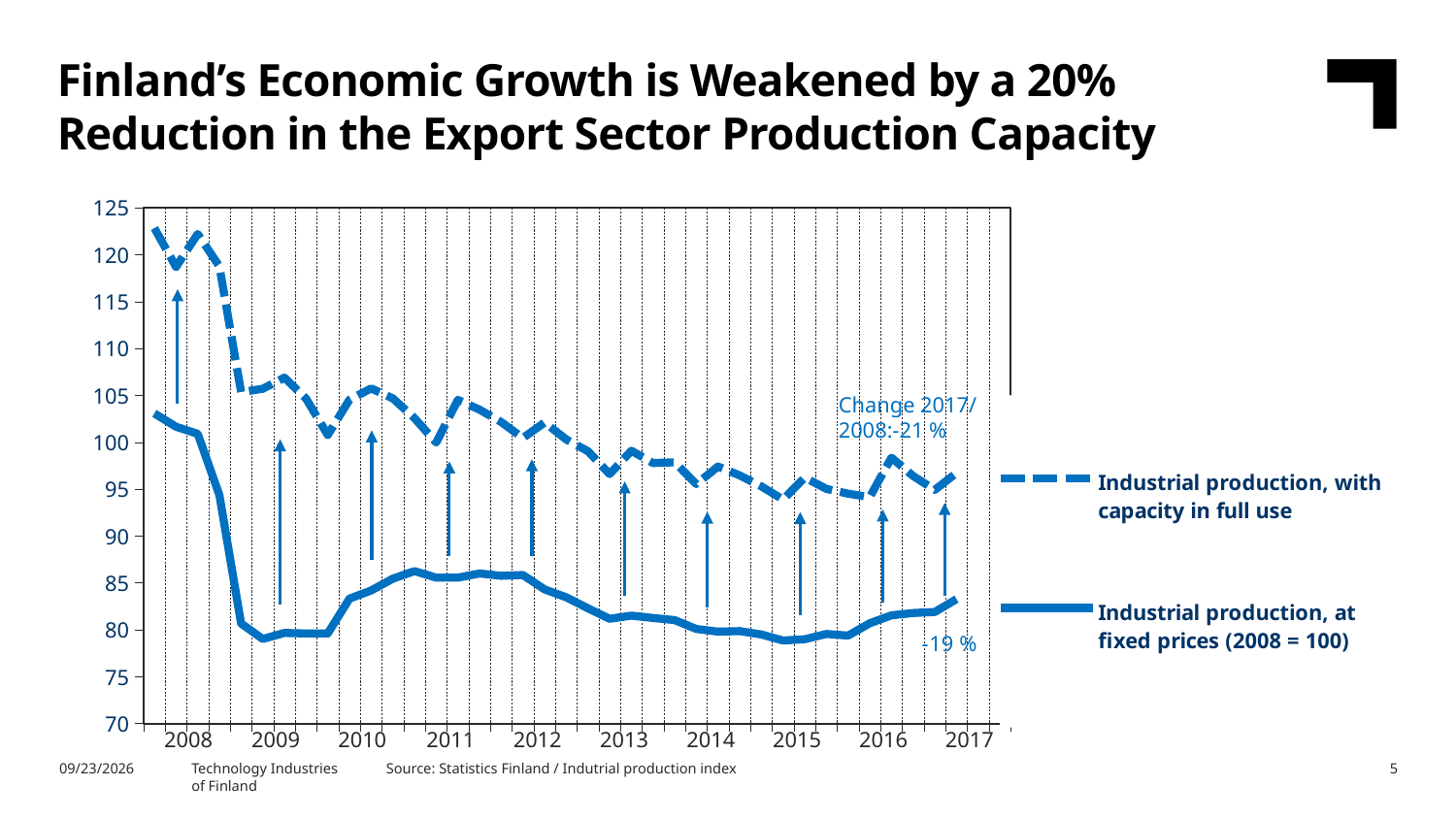
How many series does the legend list? 2 Is the value of 'Industrial production, with capacity in full use' at the start of 2008 greater or less than 120? greater In which year does the 'Industrial production, at fixed prices (2008 = 100)' line reach its highest value? 2008 Does the 'Industrial production, at fixed prices (2008 = 100)' line rise or fall overall from 2008 to 2017? fall Is the value of 'Industrial production, at fixed prices (2008 = 100)' in 2009 greater or less than 85? less Is the value of 'Industrial production, with capacity in full use' in 2017 greater or less than 100? less Which series is drawn with a dashed line? Industrial production, with capacity in full use In 2012, which series is higher: 'Industrial production, with capacity in full use' or 'Industrial production, at fixed prices (2008 = 100)'? Industrial production, with capacity in full use What percentage change is annotated next to the 'Industrial production, at fixed prices (2008 = 100)' line near 2017? -19 % What kind of chart is shown on the slide? line chart What change from 2008 to 2017 is annotated for the 'Industrial production, with capacity in full use' series? -21 % How many years are labelled on the x axis? 10